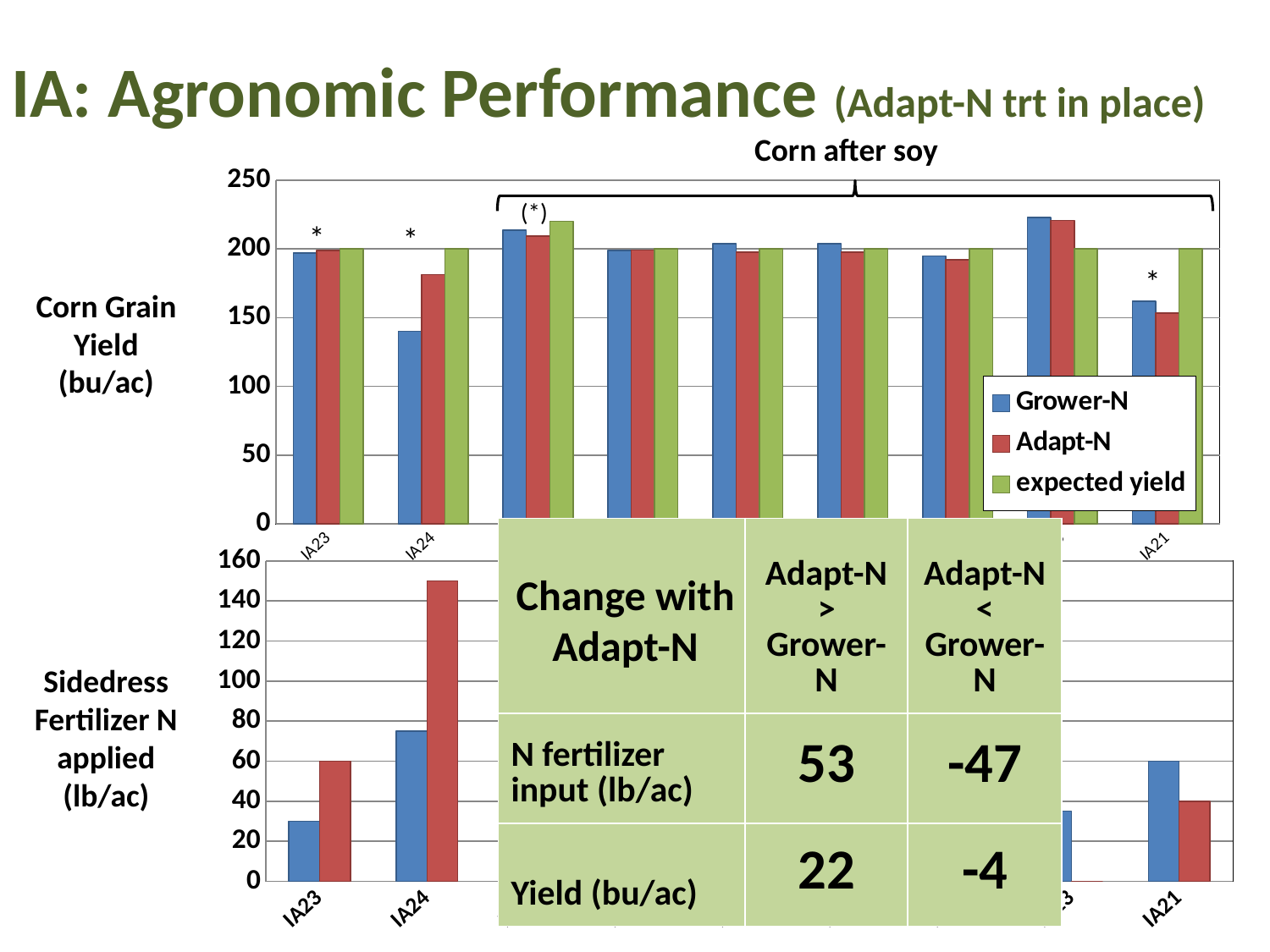
In the Corn Grain Yield chart, which is larger for IA21, the Grower-N value or the Adapt-N value? Grower-N In the Sidedress Fertilizer N applied chart at the bottom, is the red bar for IA24 greater or less than 100? greater In the Corn Grain Yield chart, is the Grower-N value for IA24 greater or less than 150? less In the Corn Grain Yield chart, is the Grower-N value for IA21 greater or less than 200? less In the Corn Grain Yield chart, which series is shown in green according to the legend? expected yield How many series does the legend of the Corn Grain Yield chart list? 3 In the Corn Grain Yield chart, which is larger for IA24, the Grower-N value or the Adapt-N value? Adapt-N What kind of chart is the Corn Grain Yield chart at the top of the slide? bar chart How many site groups of bars are plotted in the Corn Grain Yield chart? 9 In the Sidedress Fertilizer N applied chart at the bottom, which bar is taller for IA21, the blue bar or the red bar? blue bar